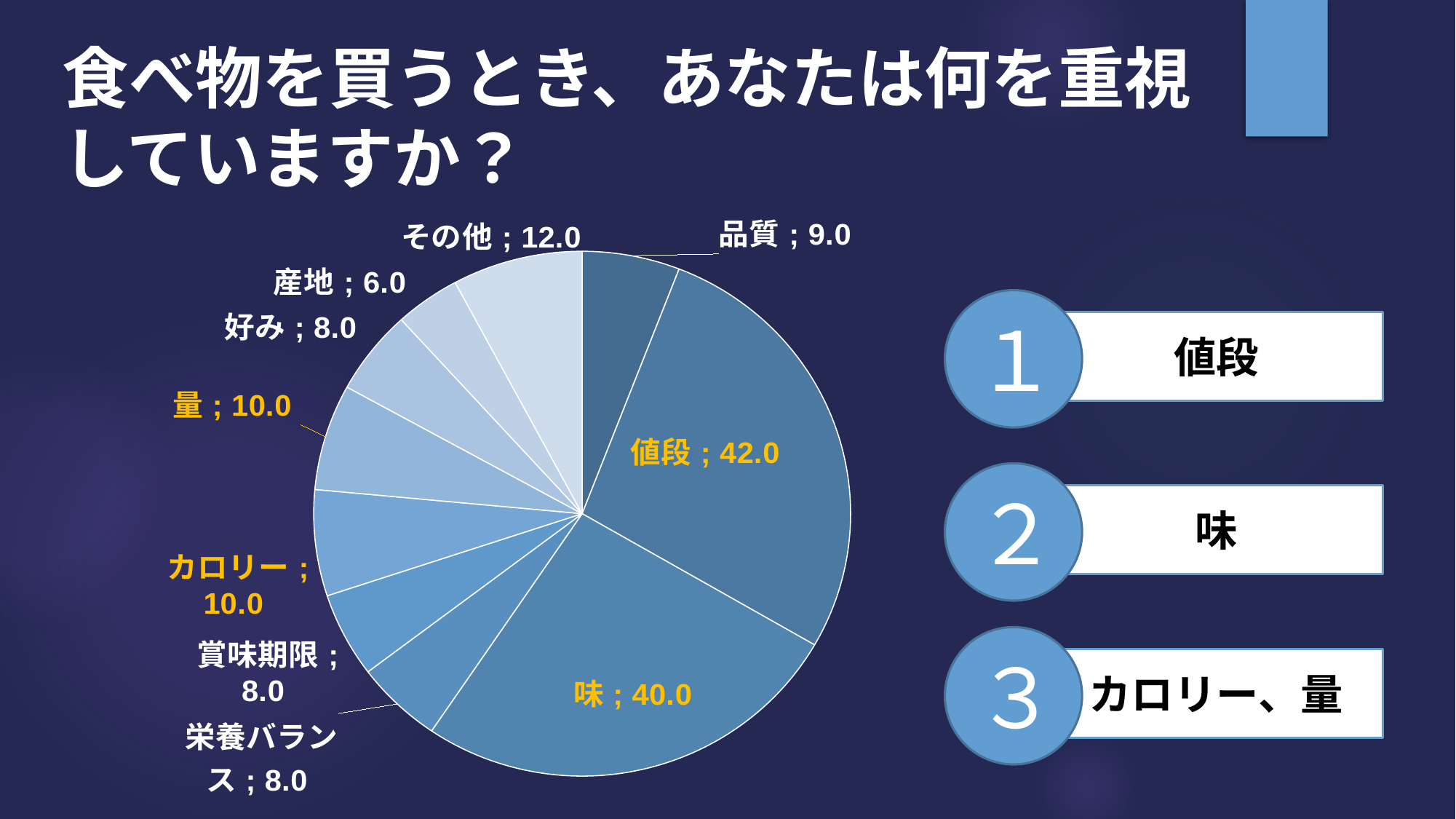
Which category has the smallest slice in the pie chart? 産地 What is the value for 品質 in the pie chart? 9.0 Which category has the largest slice in the pie chart? 値段 What type of chart is shown on the slide? pie chart What is the value for 値段 in the pie chart? 42.0 What is the difference between the values for 値段 and 味? 2.0 What is the value for 味 in the pie chart? 40.0 What is the value for その他 in the pie chart? 12.0 What is the value for 産地 in the pie chart? 6.0 Which is larger, the value for カロリー or the value for 賞味期限? カロリー How many categories are shown in the pie chart? 10 What is the difference between the values for その他 and 産地? 6.0